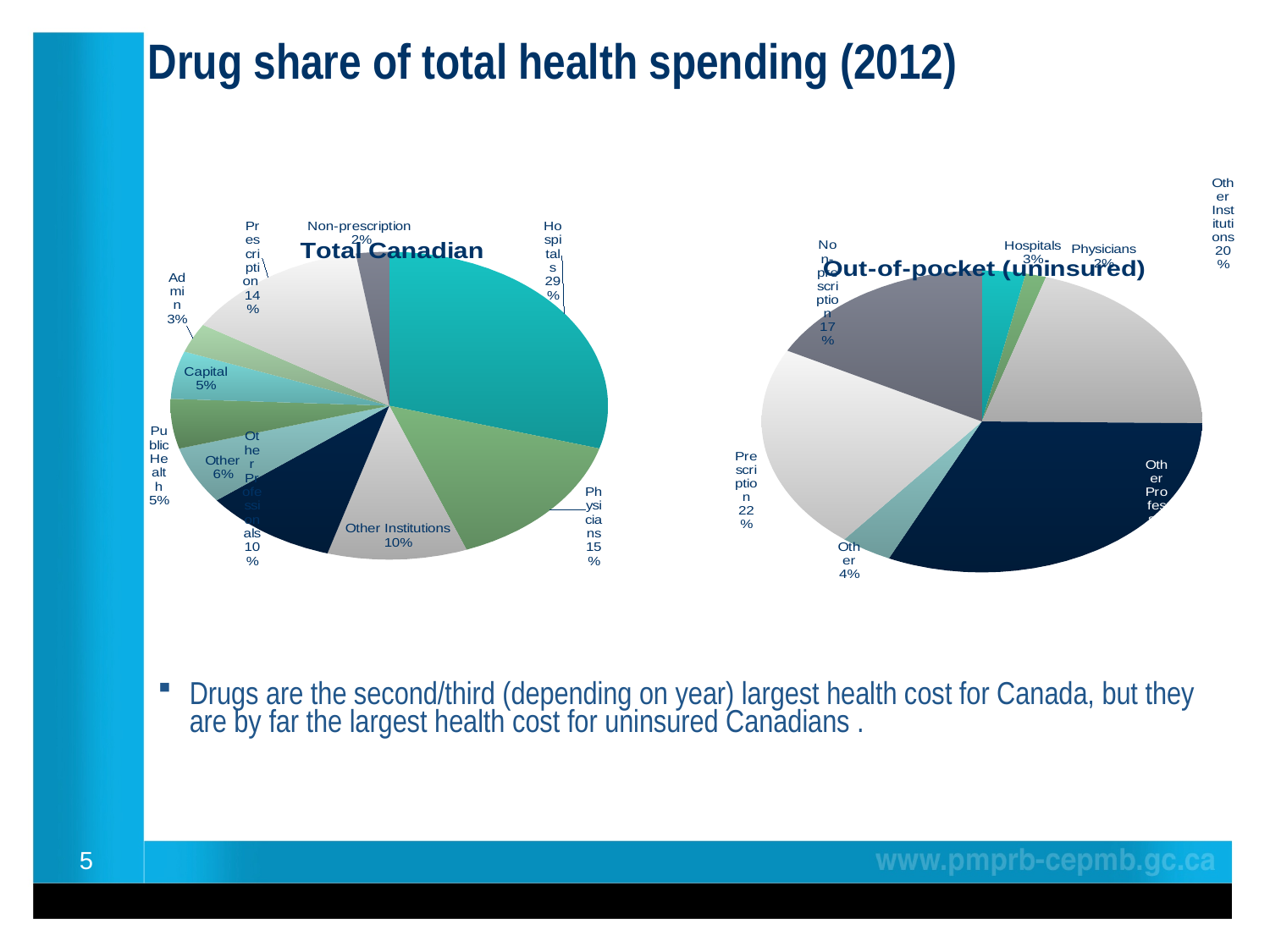
In the Total Canadian pie chart, what share is Prescription? 14% What type of charts are shown on the slide? Pie charts In the Out-of-pocket (uninsured) pie chart, what share is Other Institutions? 20% In the Total Canadian pie chart, what share is Hospitals? 29% In the Out-of-pocket (uninsured) pie chart, what share is Prescription? 22% In the Total Canadian pie chart, how many percentage points larger is Hospitals than Physicians? 14 percentage points In the Total Canadian pie chart, which category has the largest share? Hospitals In the Out-of-pocket (uninsured) pie chart, which category has the smallest share? Physicians In the Out-of-pocket (uninsured) pie chart, what share is Non-prescription? 17% In the Out-of-pocket (uninsured) pie chart, how many percentage points larger is Prescription than Non-prescription? 5 percentage points In the Total Canadian pie chart, which category has the smallest share? Non-prescription In the Total Canadian pie chart, which is larger: Physicians or Other Institutions? Physicians